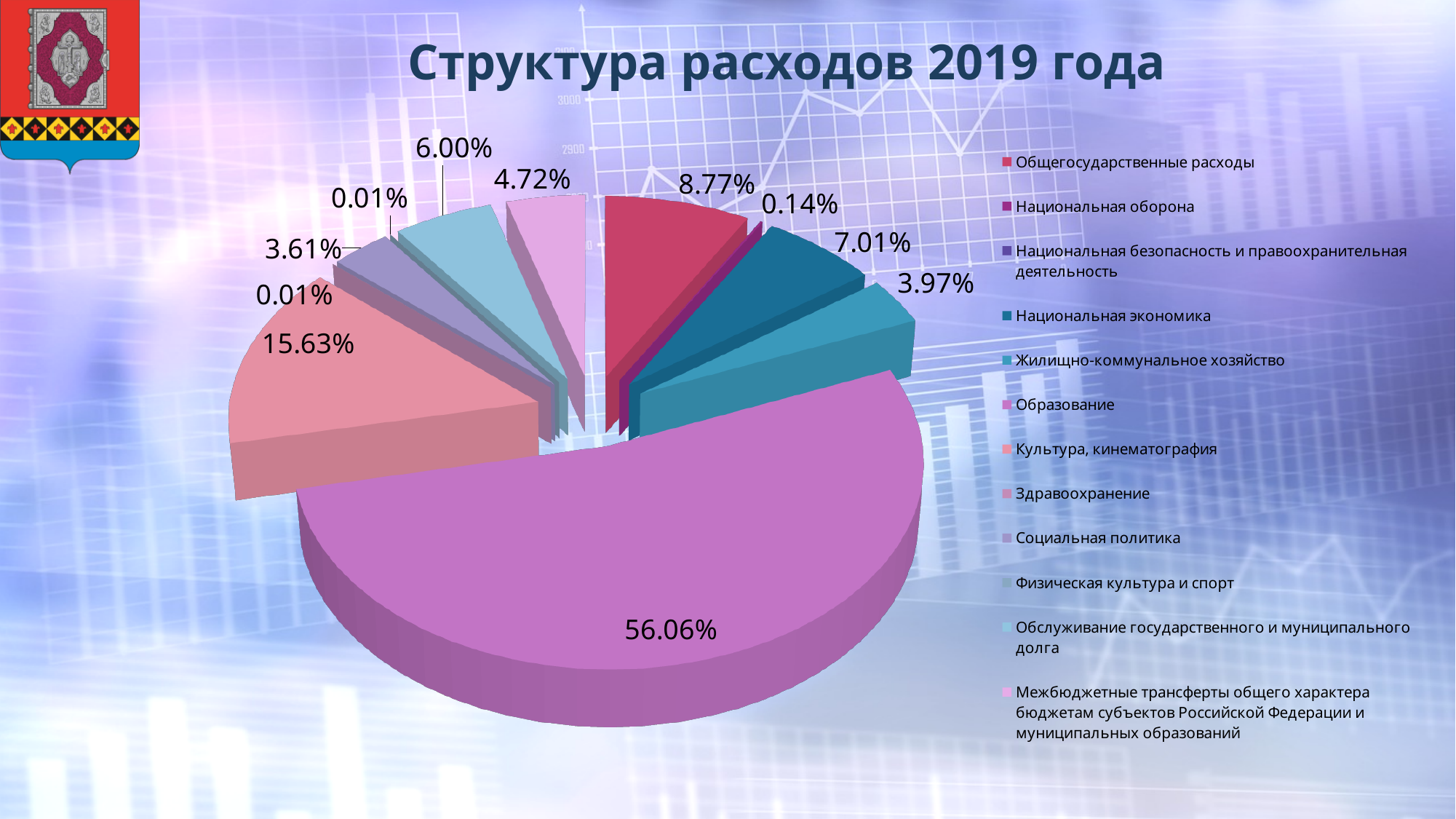
What is the smallest percentage value printed on the chart? 0.01% Is the share for Образование greater or less than 50%? greater What is the value shown for Общегосударственные расходы? 8.77% What is the second-largest percentage value printed on the chart? 15.63% What share of the pie does the largest slice (Образование) have? 56.06% How many categories does the legend list? 12 What is the title of the chart? Структура расходов 2019 года Which category has the largest share of the pie? Образование What kind of chart is shown on the slide? pie chart Which is larger: the slice labelled 56.06% or the slice labelled 15.63%? the slice labelled 56.06% Is the share for Общегосударственные расходы greater or less than 10%? less What is the difference between the largest slice (56.06%) and the second-largest slice (15.63%)? 40.43 percentage points